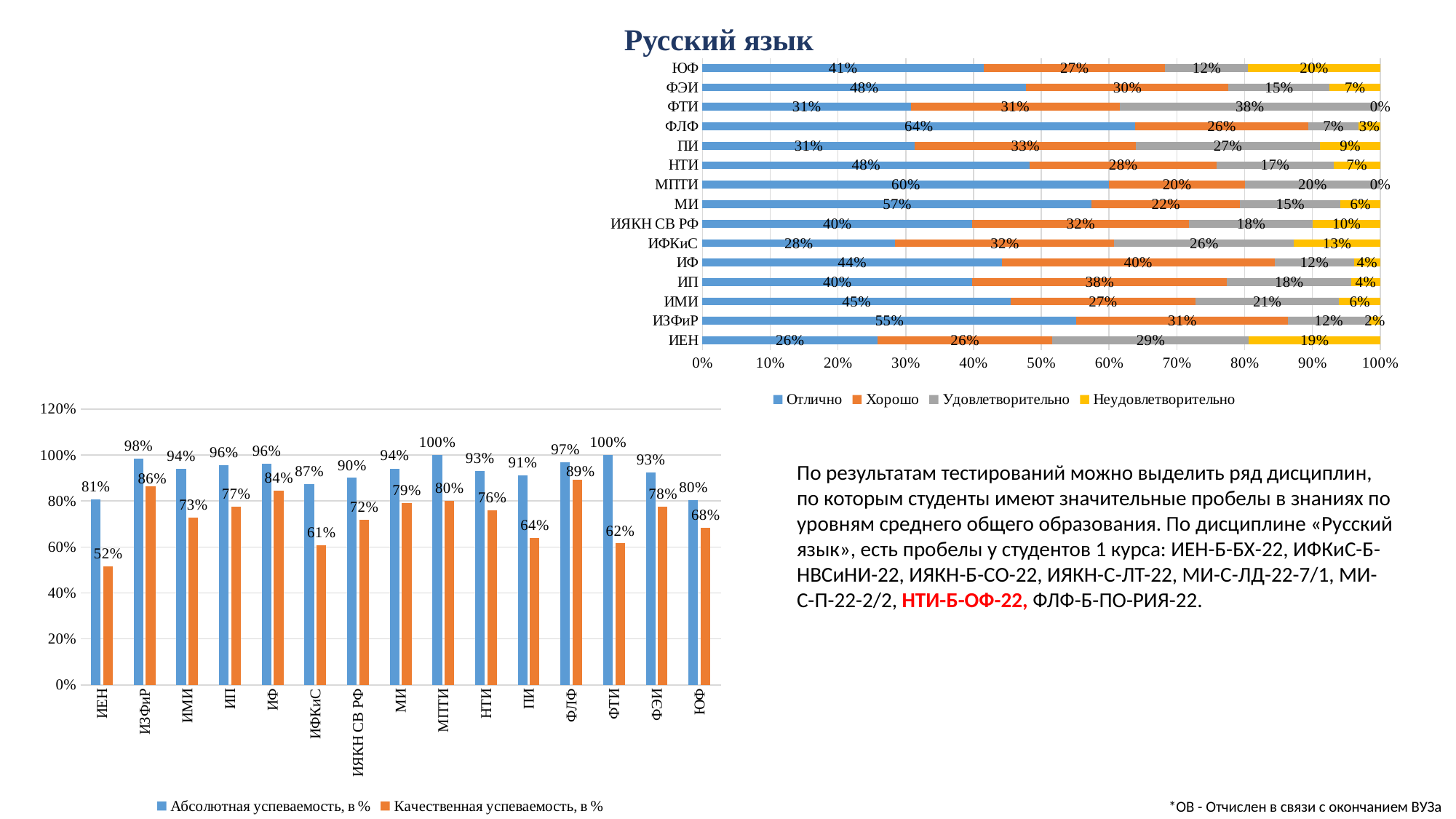
In the chart titled «Русский язык», which category has the lowest «Отлично» share? ИЕН In the chart titled «Русский язык», how many series does the legend list? 4 In the chart titled «Русский язык», which category has the highest «Отлично» share? ФЛФ In the chart titled «Русский язык», which is larger: the «Хорошо» value for ИФ or for МПТИ? ИФ In the chart titled «Русский язык», what is the difference between the «Удовлетворительно» values for ФТИ and ФЛФ? 31% In the bottom-left chart, how many categories are shown on the x axis? 15 In the bottom-left chart, what is the difference between the «Абсолютная успеваемость» and «Качественная успеваемость» values for ФТИ? 38% In the bottom-left chart, what is the «Качественная успеваемость, в %» value for ИЕН? 52% In the bottom-left chart, what is the «Абсолютная успеваемость, в %» value for ИЗФиР? 98% In the bottom-left chart, which category has the lowest «Качественная успеваемость, в %»? ИЕН In the chart titled «Русский язык», what is the «Отлично» value for ФЛФ? 64% In the chart titled «Русский язык», what is the «Неудовлетворительно» value for ИЕН? 19%